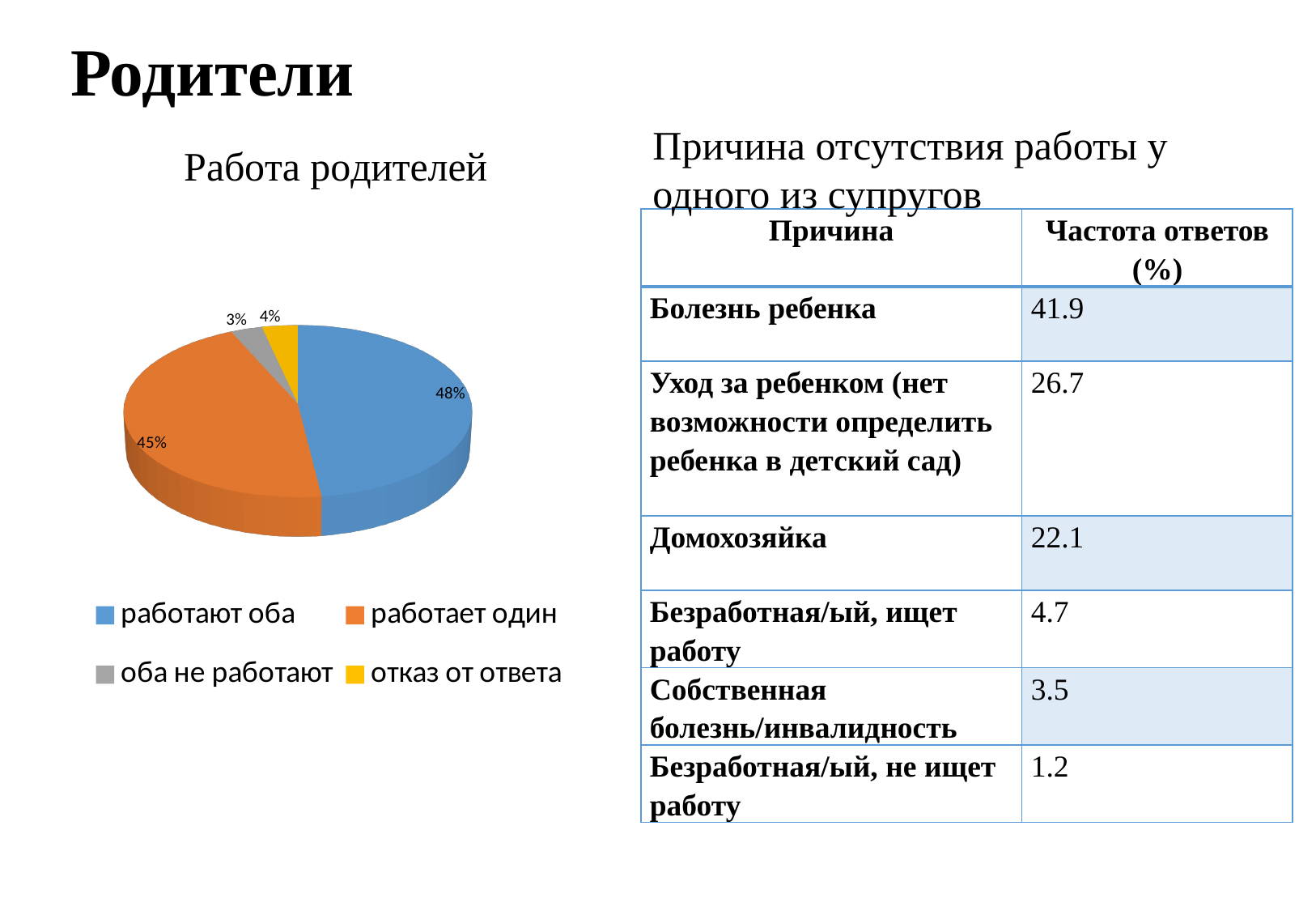
What is the title of the pie chart on the slide? Работа родителей In the "Работа родителей" chart, what share is shown for "работают оба"? 48% What kind of chart is "Работа родителей"? pie chart In the "Работа родителей" chart, which is larger: "отказ от ответа" or "оба не работают"? отказ от ответа What colour is the "работает один" slice in the "Работа родителей" chart? orange In the "Работа родителей" chart, what share is shown for "отказ от ответа"? 4% In the "Работа родителей" chart, what share is shown for "оба не работают"? 3% In the "Работа родителей" chart, what share is shown for "работает один"? 45% Which category has the smallest slice in the "Работа родителей" chart? оба не работают Which category has the largest slice in the "Работа родителей" chart? работают оба How many slices does the "Работа родителей" pie chart have? 4 In the "Работа родителей" chart, what is the difference between the shares for "работают оба" and "работает один"? 3%